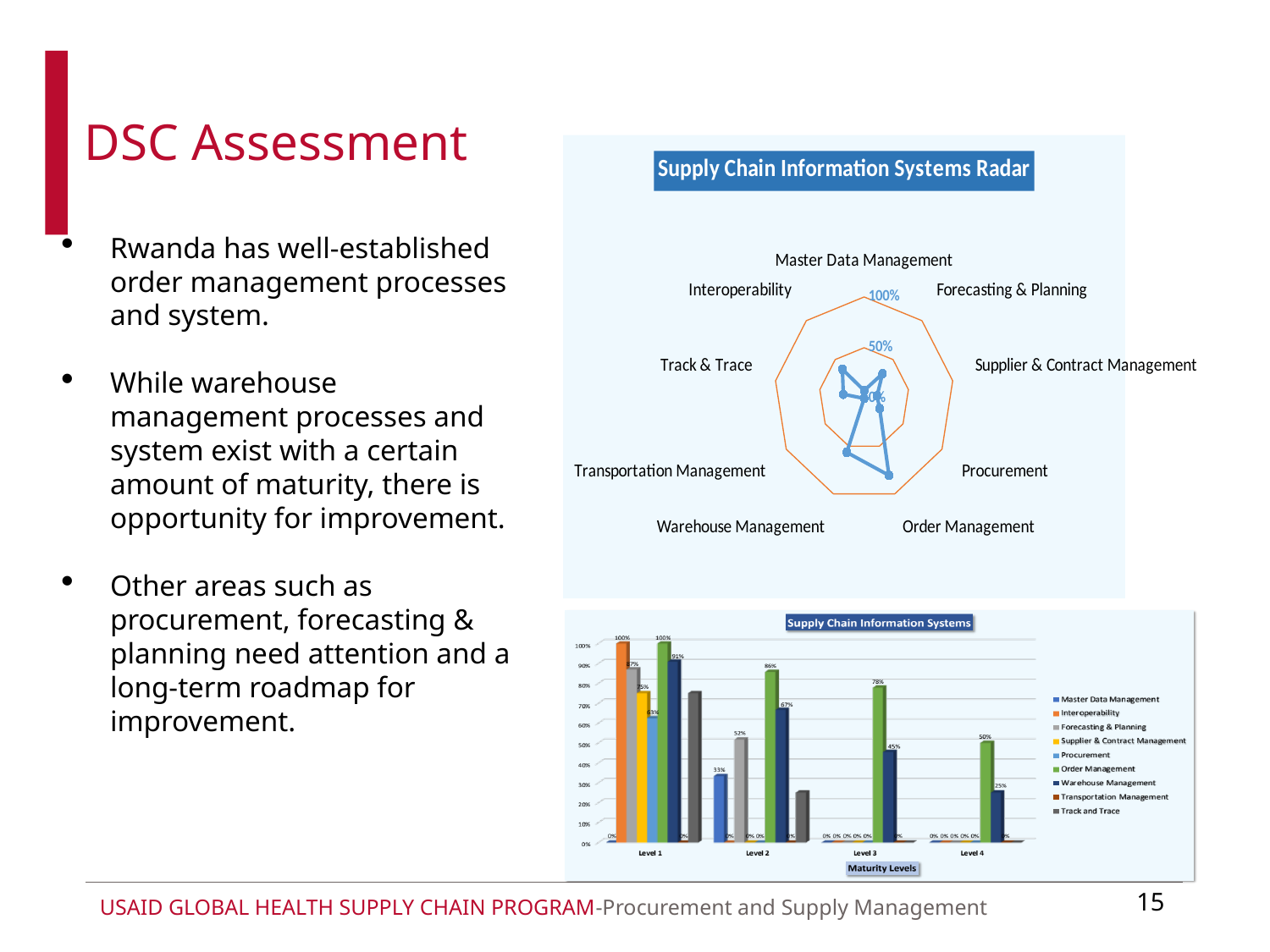
In the 'Supply Chain Information Systems' bar chart, what is the value for Warehouse Management at Level 3? 45% In the 'Supply Chain Information Systems' bar chart, which is larger at Level 2: Order Management or Forecasting & Planning? Order Management In the 'Supply Chain Information Systems' bar chart, what is the value for Master Data Management at Level 2? 33% How many categories are plotted on the 'Supply Chain Information Systems Radar' chart? 9 On the 'Supply Chain Information Systems Radar' chart, is the value for Procurement greater or less than 50%? less How many series does the legend of the 'Supply Chain Information Systems' bar chart list? 9 How many maturity levels are shown on the x axis of the 'Supply Chain Information Systems' bar chart? 4 What kind of chart is the 'Supply Chain Information Systems Radar' chart? Radar chart On the 'Supply Chain Information Systems Radar' chart, which category has the highest value? Order Management In the 'Supply Chain Information Systems' bar chart, what is the value for Order Management at Level 2? 86% In the 'Supply Chain Information Systems' bar chart, does the value for Order Management rise or fall from Level 1 to Level 4? Fall In the 'Supply Chain Information Systems' bar chart, what is the difference between Order Management and Warehouse Management at Level 3? 33%